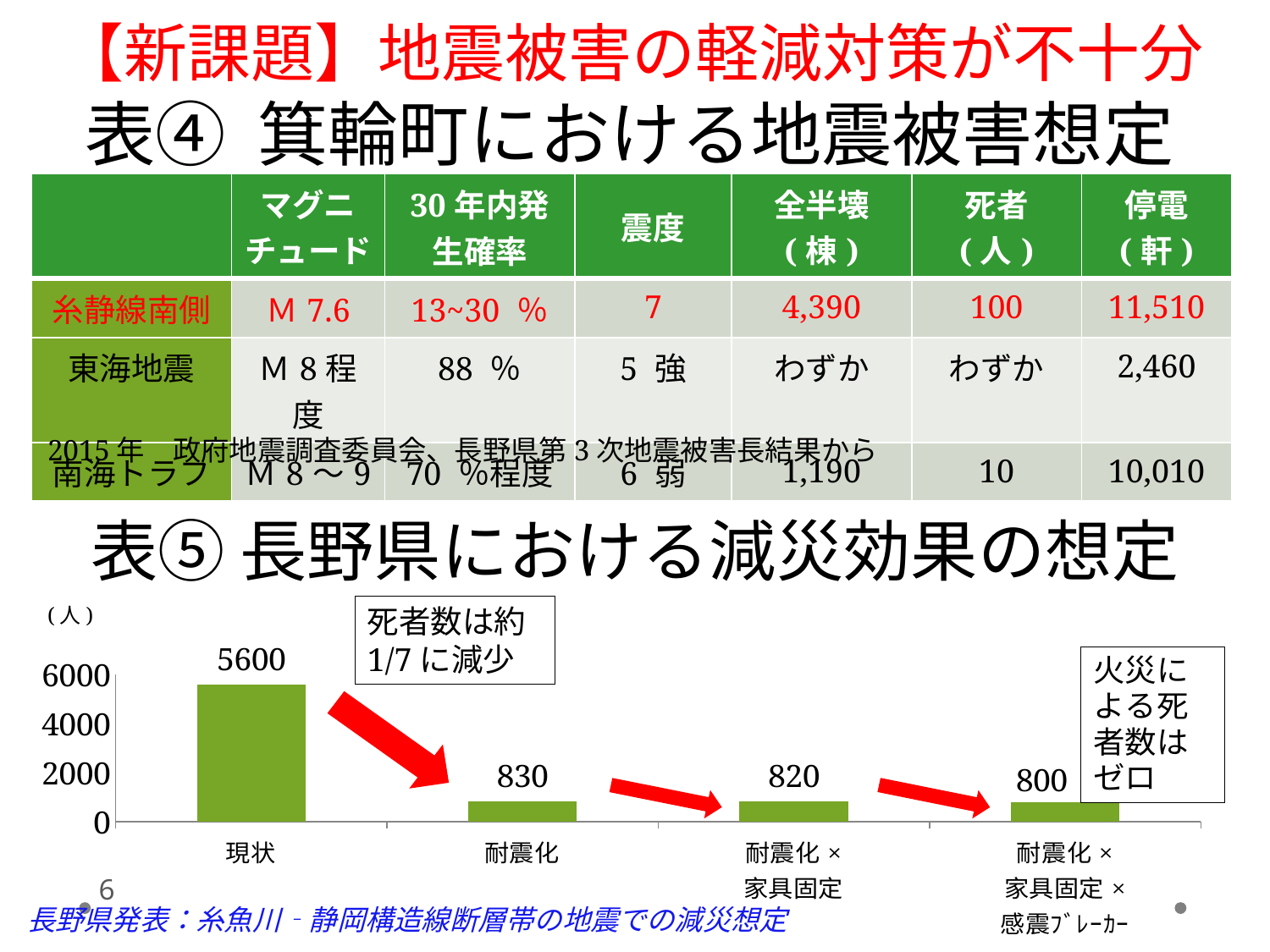
What kind of chart is shown under 表⑤? bar chart In the bar chart under 表⑤, what is the difference between the values for 現状 and 耐震化? 4770 In the bar chart under 表⑤, which category has the highest value? 現状 In the bar chart under 表⑤, what is the value for 耐震化? 830 In the bar chart under 表⑤, what is the difference between the values for 耐震化 and 耐震化×家具固定×感震ブレーカー? 30 In the bar chart under 表⑤, which category has the lowest value? 耐震化×家具固定×感震ブレーカー How many categories are shown in the bar chart under 表⑤? 4 In the bar chart under 表⑤, is the value for 現状 greater or less than 4000? greater In the bar chart under 表⑤, what is the value for 現状? 5600 In the bar chart under 表⑤, what is the value for 耐震化×家具固定? 820 In the bar chart under 表⑤, which is larger, the value for 現状 or the value for 耐震化? 現状 In the bar chart under 表⑤, what is the value for 耐震化×家具固定×感震ブレーカー? 800